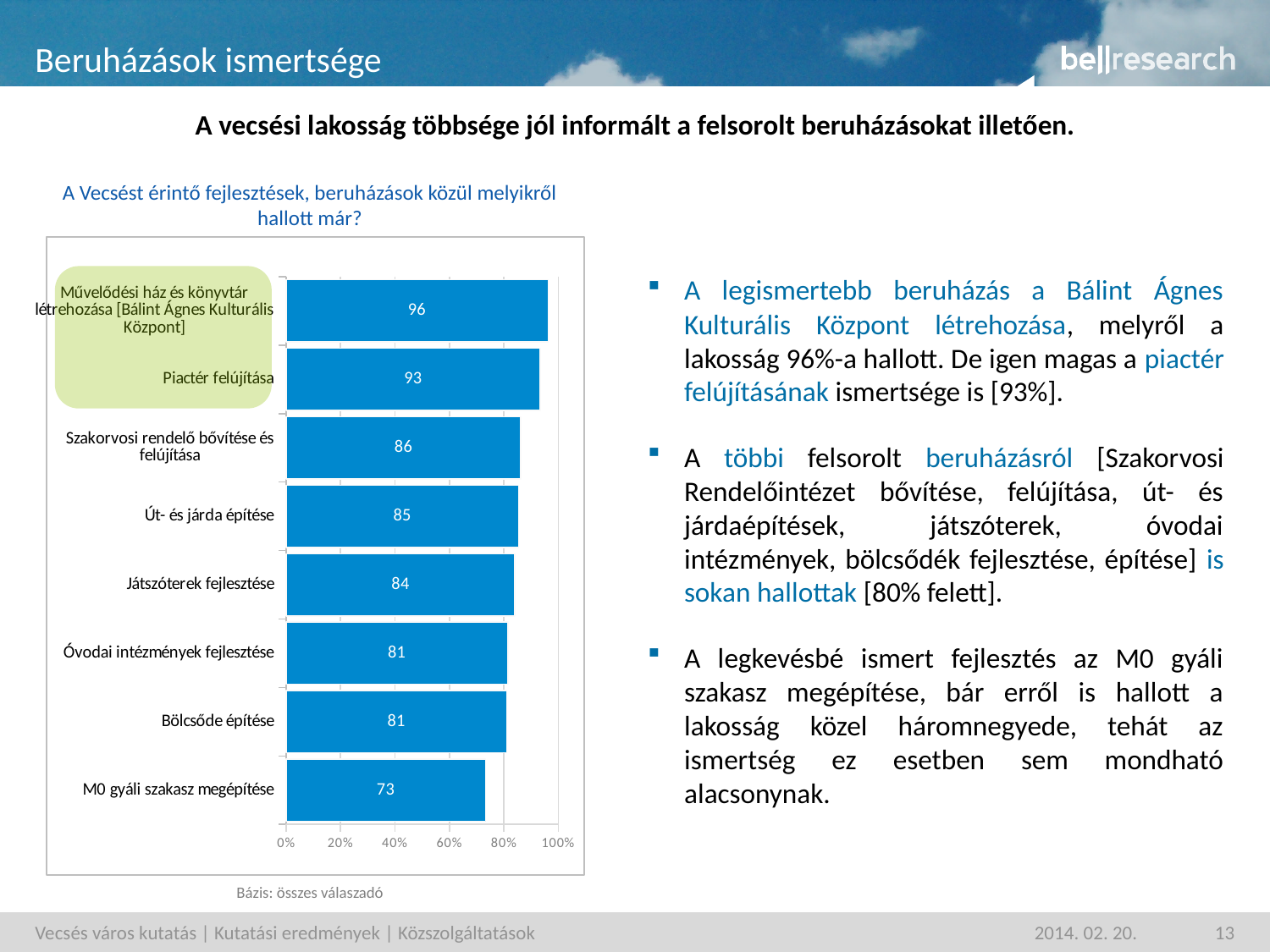
What kind of chart is shown on the slide? bar chart What is the difference between the values for "Művelődési ház és könyvtár létrehozása [Bálint Ágnes Kulturális Központ]" and "M0 gyáli szakasz megépítése"? 23 How many categories are shown in the chart? 8 Which category has the highest value? Művelődési ház és könyvtár létrehozása [Bálint Ágnes Kulturális Központ] What is the difference between the values for "Szakorvosi rendelő bővítése és felújítása" and "Út- és járda építése"? 1 Is the value for "M0 gyáli szakasz megépítése" greater or less than 80%? less What value is shown for "Játszóterek fejlesztése"? 84 What value is shown for "Piactér felújítása"? 93 Which category has the lowest value? M0 gyáli szakasz megépítése Which is larger, the value for "Piactér felújítása" or the value for "Bölcsőde építése"? Piactér felújítása What value is shown for "M0 gyáli szakasz megépítése"? 73 What is the title of the chart? A Vecsést érintő fejlesztések, beruházások közül melyikről hallott már?